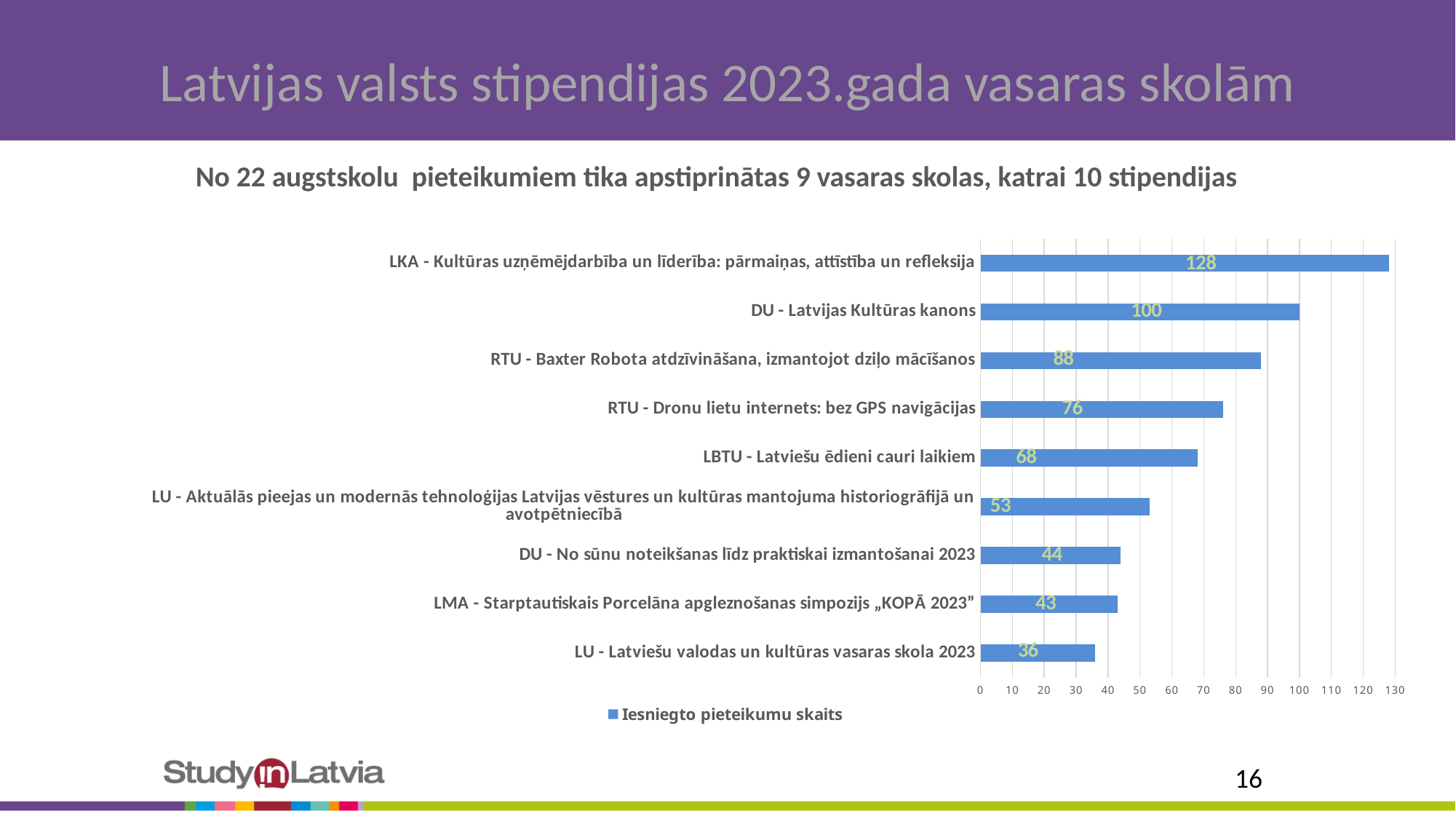
What is the legend entry of the chart? Iesniegto pieteikumu skaits What is the difference between the values for "RTU - Baxter Robota atdzīvināšana, izmantojot dziļo mācīšanos" and "RTU - Dronu lietu internets: bez GPS navigācijas"? 12 Which is larger: the value for "DU - No sūnu noteikšanas līdz praktiskai izmantošanai 2023" or "LMA - Starptautiskais Porcelāna apgleznošanas simpozijs „KOPĀ 2023”"? DU - No sūnu noteikšanas līdz praktiskai izmantošanai 2023 What is the value for "DU - Latvijas Kultūras kanons"? 100 How many series does the legend list? 1 What is the value for "LBTU - Latviešu ēdieni cauri laikiem"? 68 Which category has the lowest value? LU - Latviešu valodas un kultūras vasaras skola 2023 What is the value for "LU - Latviešu valodas un kultūras vasaras skola 2023"? 36 Which category has the highest value? LKA - Kultūras uzņēmējdarbība un līderība: pārmaiņas, attīstība un refleksija Is the value for "LU - Aktuālās pieejas un modernās tehnoloģijas Latvijas vēstures un kultūras mantojuma historiogrāfijā un avotpētniecībā" greater or less than 60? less How many categories are shown in the chart? 9 What kind of chart is shown on the slide? bar chart